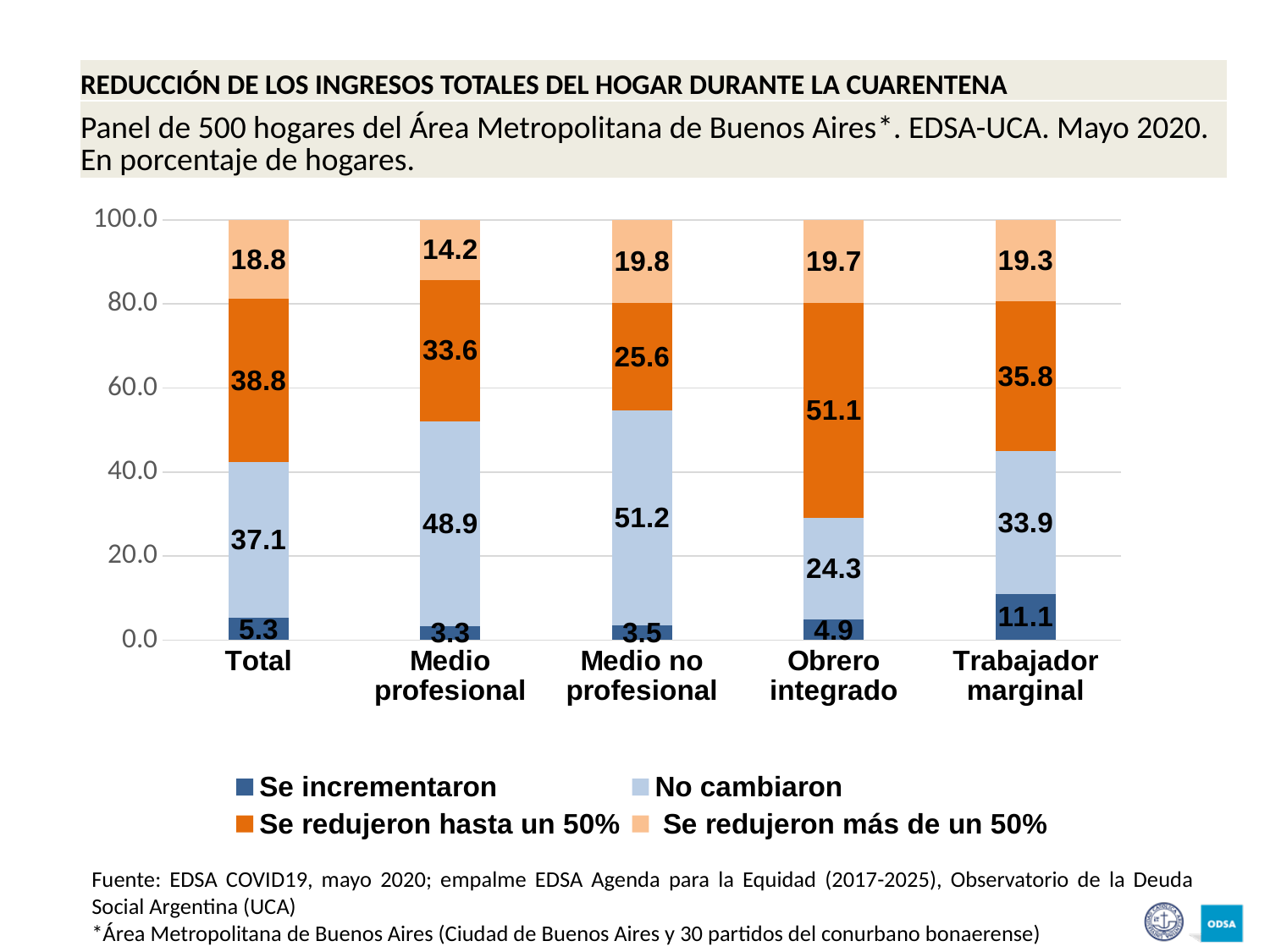
Which category has the lowest value for 'Se redujeron más de un 50%'? Medio profesional What is the value of 'Se incrementaron' for Total? 5.3 What is the difference between 'No cambiaron' and 'Se incrementaron' for Total? 31.8 What is the value of 'Se redujeron hasta un 50%' for Obrero integrado? 51.1 Which legend entry is shown in dark orange? Se redujeron hasta un 50% What is the value of 'No cambiaron' for Medio no profesional? 51.2 What is the difference between the 'Se redujeron hasta un 50%' values for Obrero integrado and Medio no profesional? 25.5 How many categories are shown on the x axis? 5 What kind of chart is shown on the slide? Stacked bar chart Which has a larger 'No cambiaron' value, Medio profesional or Trabajador marginal? Medio profesional Which category has the highest value for 'Se incrementaron'? Trabajador marginal How many series does the legend list? 4